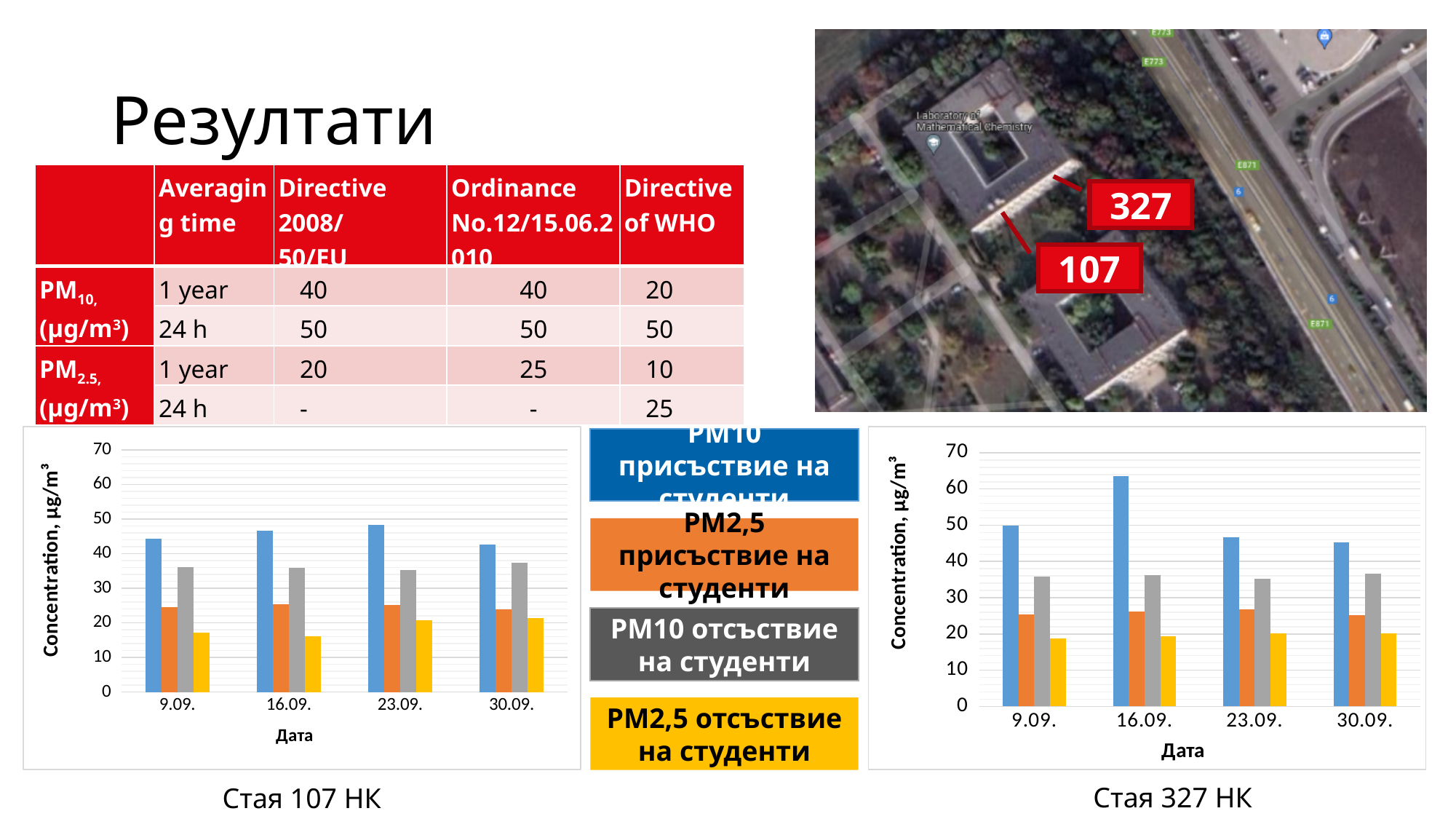
How many dates are shown on the x axis of the chart titled Стая 327 НК? 4 In the chart titled Стая 327 НК, on which date is the PM10 присъствие на студенти value highest? 16.09. In the chart titled Стая 327 НК, is the PM10 присъствие на студенти value for 16.09. greater or less than 60? greater What kind of chart is the chart titled Стая 107 НК? bar chart How many series does the legend between the two charts list? 4 In the chart titled Стая 107 НК, is the PM2,5 отсъствие на студенти value for 16.09. greater or less than 20? less Which colour represents PM2,5 отсъствие на студенти in the legend? yellow In the chart titled Стая 327 НК, is the PM10 отсъствие на студенти value for 9.09. greater or less than 30? greater In the chart titled Стая 107 НК, which is larger on 9.09.: PM10 присъствие на студенти or PM2,5 присъствие на студенти? PM10 присъствие на студенти What is the y-axis title of the chart titled Стая 107 НК? Concentration, µg/m³ In the chart titled Стая 327 НК, which is larger: the PM10 присъствие на студенти value for 16.09. or for 9.09.? 16.09.